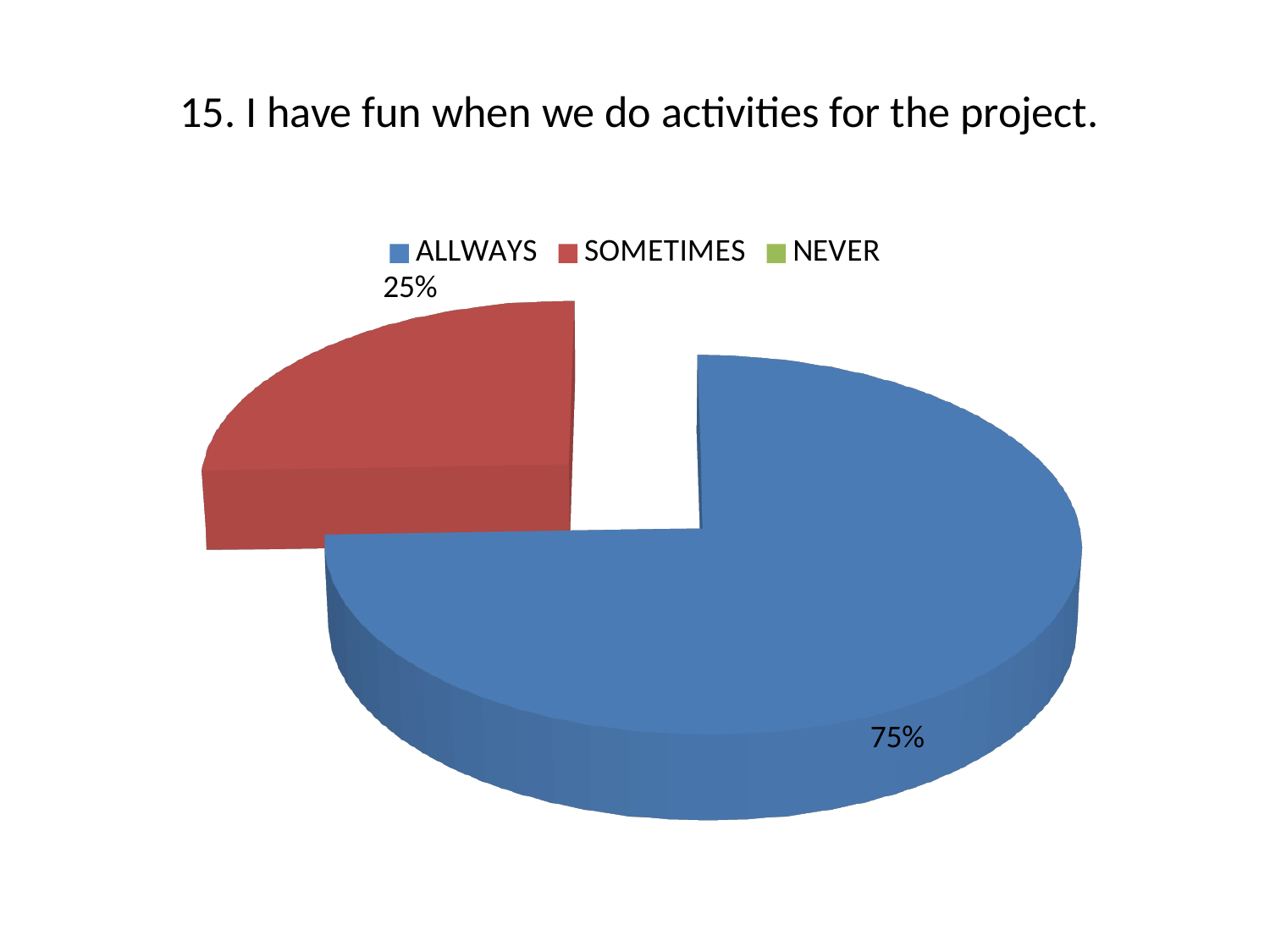
Which category has the largest slice of the pie? ALLWAYS What kind of chart is shown on the slide? pie chart Is the share for ALLWAYS greater or less than 50%? greater What is the difference in percentage points between the ALLWAYS and SOMETIMES shares? 50 What is the title of the chart? 15. I have fun when we do activities for the project. What colour is the SOMETIMES slice? red How many categories does the legend list? 3 What share of the pie does SOMETIMES have? 25% Which of ALLWAYS or SOMETIMES has the larger share? ALLWAYS What share of the pie does ALLWAYS have? 75%